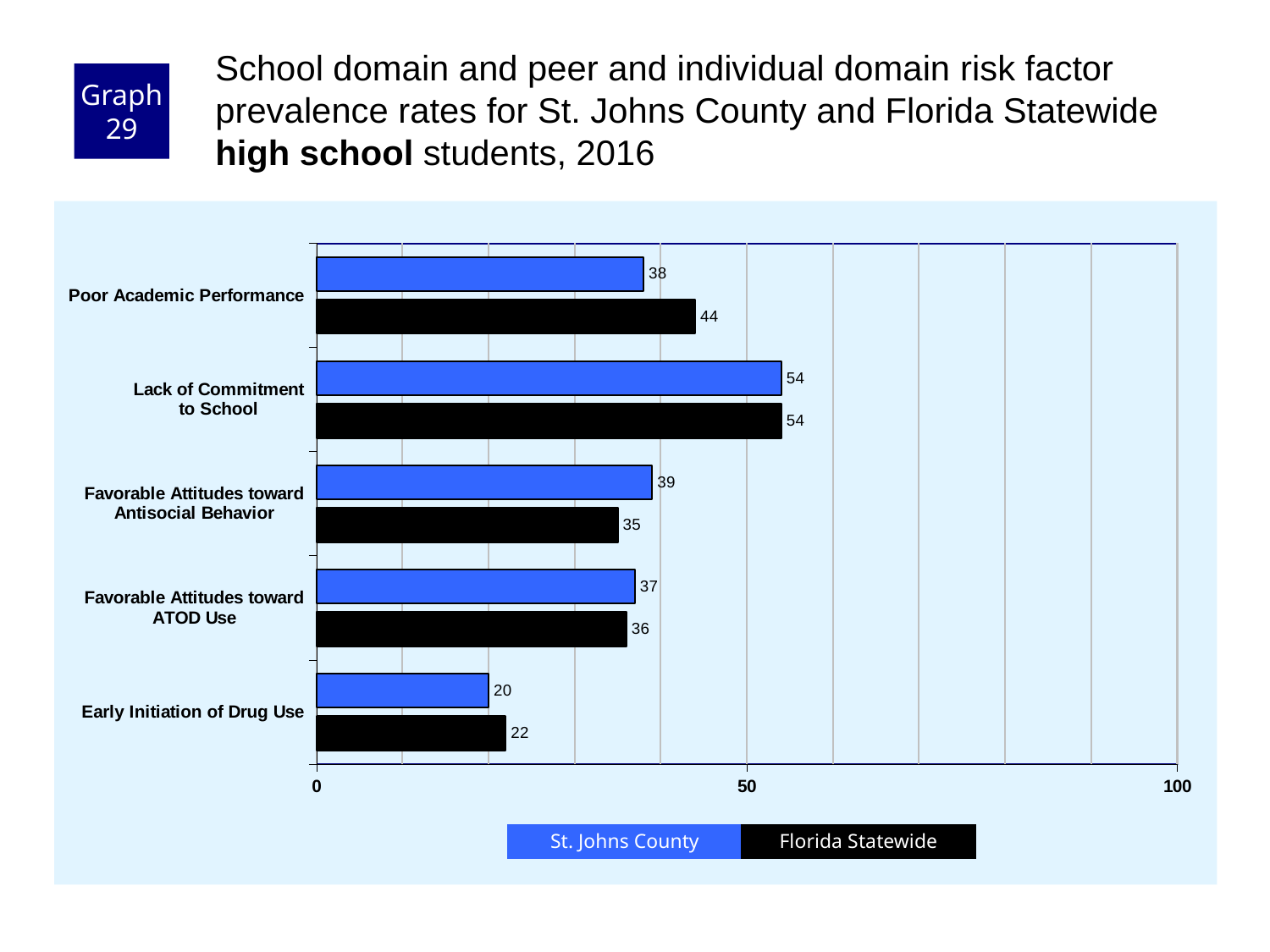
Which risk factor has the highest St. Johns County value? Lack of Commitment to School What is the St. Johns County value for Poor Academic Performance? 38 What is the Florida Statewide value for Favorable Attitudes toward Antisocial Behavior? 35 How many risk factor categories are shown on the chart? 5 Is the St. Johns County value for Lack of Commitment to School greater or less than 50? greater Which colour represents Florida Statewide in the chart? black How many series does the legend list? 2 What is the Florida Statewide value for Early Initiation of Drug Use? 22 What is the difference between the Florida Statewide and St. Johns County values for Poor Academic Performance? 6 Which risk factor has the lowest Florida Statewide value? Early Initiation of Drug Use For Favorable Attitudes toward Antisocial Behavior, which is larger: the St. Johns County value or the Florida Statewide value? St. Johns County What kind of chart is shown on the slide? bar chart